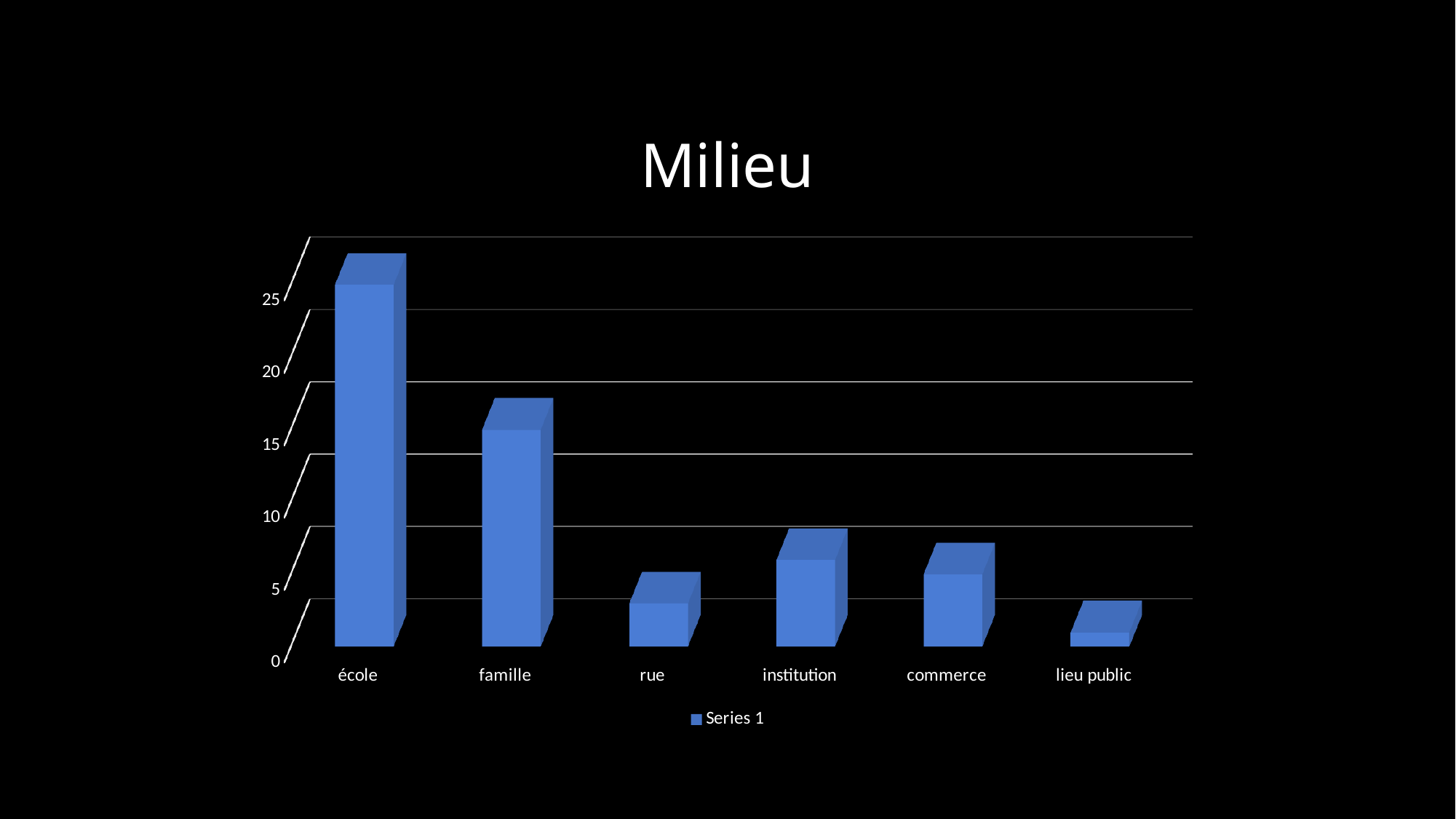
How many series does the legend list? 1 Is the value for famille greater or less than 10? greater Is the value for école greater or less than 20? greater What is the name of the series shown in the legend? Series 1 What is the title of the chart? Milieu How many categories are shown on the x axis of the chart? 6 Which category has the highest value? école Is the value for lieu public greater or less than 5? less Which category has the lowest value? lieu public Which has the larger value, famille or rue? famille Which has the larger value, rue or institution? institution What kind of chart is shown on the slide? bar chart